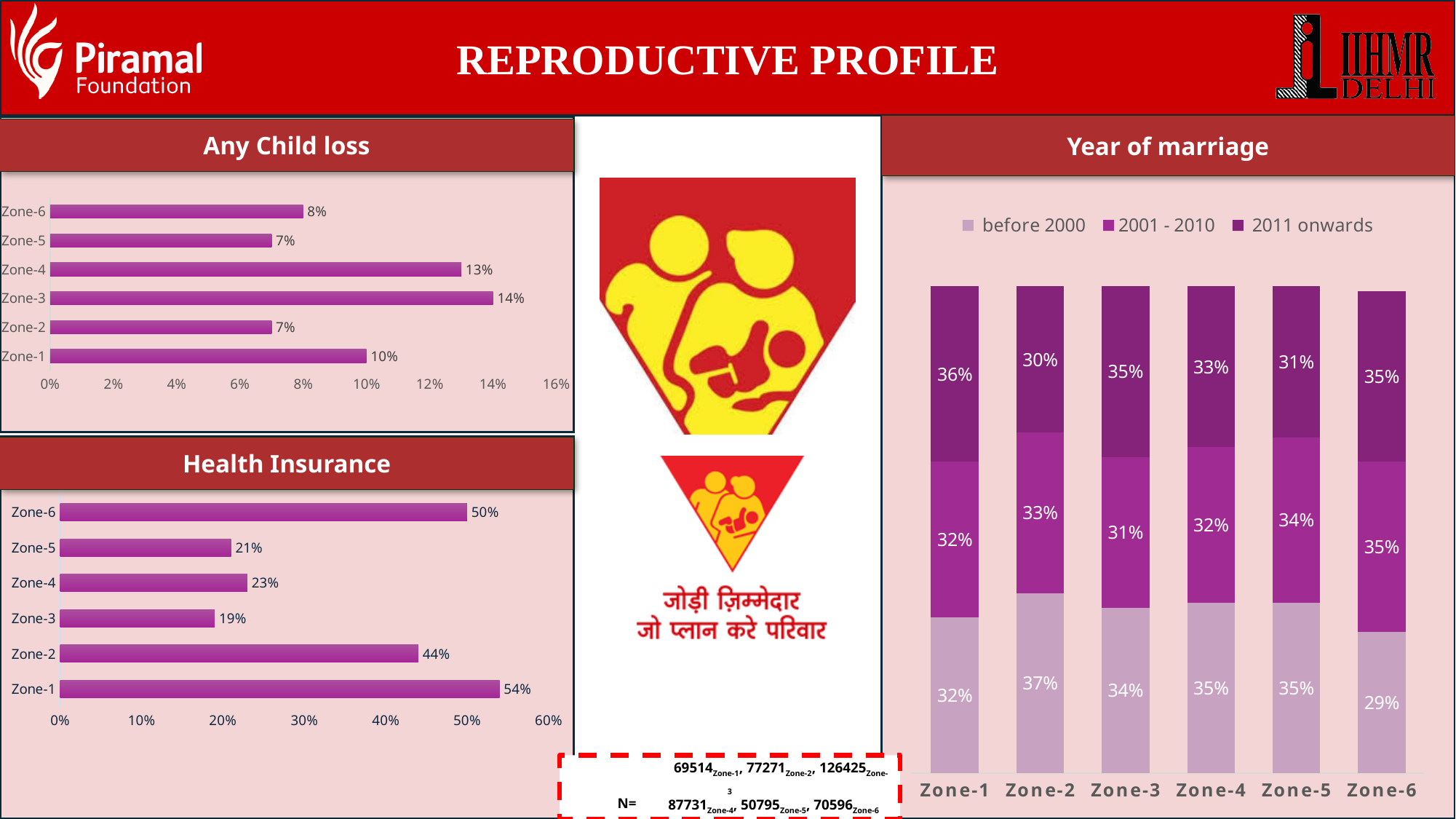
In the Year of marriage chart, how many series does the legend list? 3 In the Year of marriage chart, what is the '2011 onwards' value for Zone-2? 30% In the Health Insurance chart, which zone has the highest value? Zone-1 In the Health Insurance chart, which is larger, Zone-2 or Zone-4? Zone-2 What kind of chart is the Year of marriage chart? Stacked bar chart In the Health Insurance chart, what is the value for Zone-6? 50% In the Year of marriage chart, what is the 'before 2000' value for Zone-6? 29% In the Any Child loss chart, what is the value for Zone-3? 14% In the Health Insurance chart, how many zones are shown? 6 In the Any Child loss chart, which zone has the lowest value? Zone-2 and Zone-5 (7%) In the Any Child loss chart, what is the difference between Zone-4 and Zone-1? 3% In the Health Insurance chart, which zone has the lowest value? Zone-3